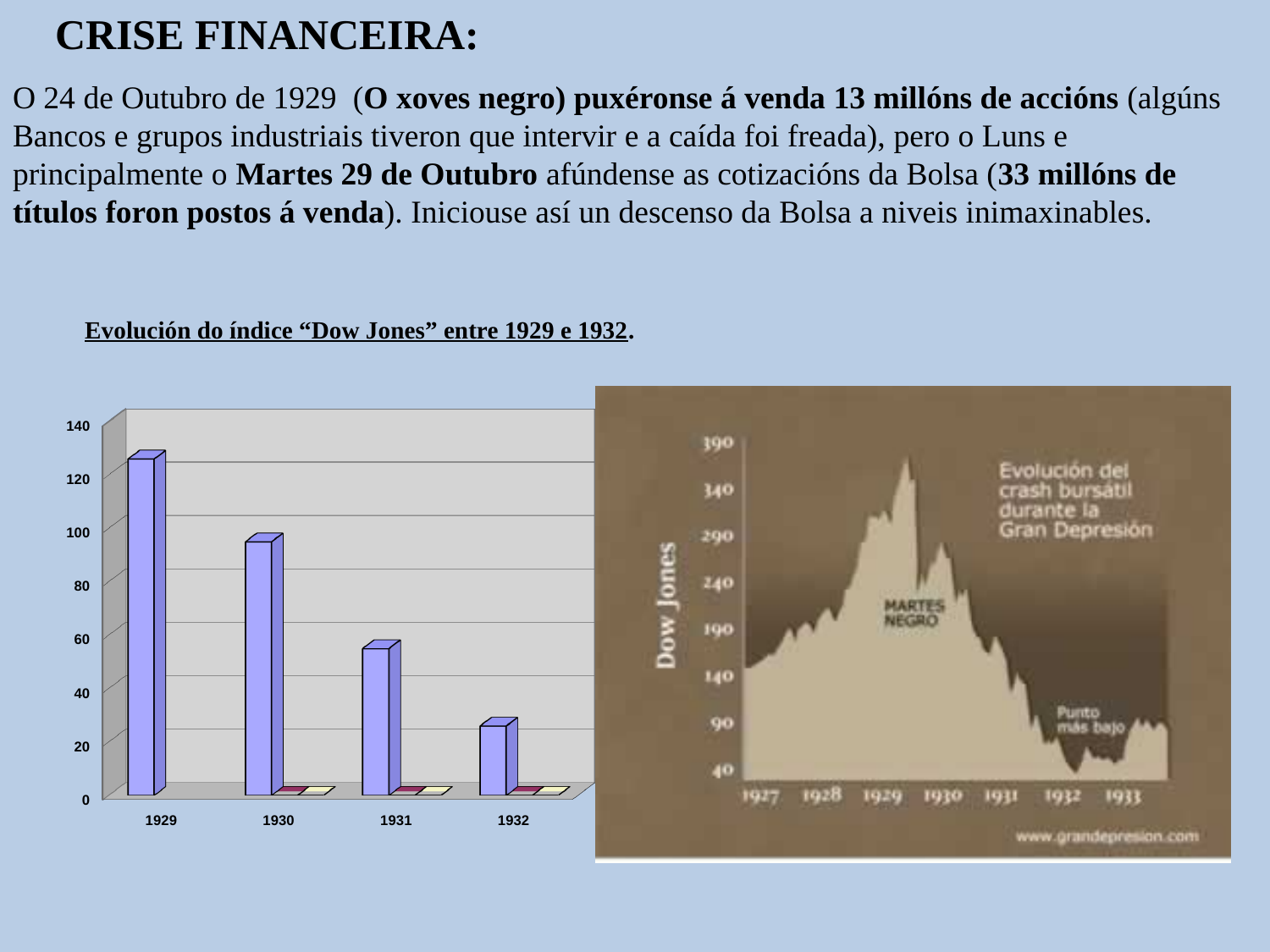
In the bar chart on the left, which year has the larger value, 1930 or 1931? 1930 In the bar chart on the left, is the value for 1931 greater or less than 40? greater In the bar chart on the left, which year has the highest bar? 1929 In the bar chart on the left, how many years are shown on the x axis? 4 What is the title written above the charts on the slide? Evolución do índice "Dow Jones" entre 1929 e 1932 In the bar chart on the left, is the value for 1930 greater or less than 80? greater In the bar chart on the left, which year has the lowest bar? 1932 What kind of chart is the chart on the left of the slide? bar chart In the bar chart on the left, is the value for 1929 greater or less than 100? greater In the bar chart on the left, do the values rise or fall from 1929 to 1932? fall In the chart on the right, which year on the x axis is the peak of the Dow Jones line closest to? 1929